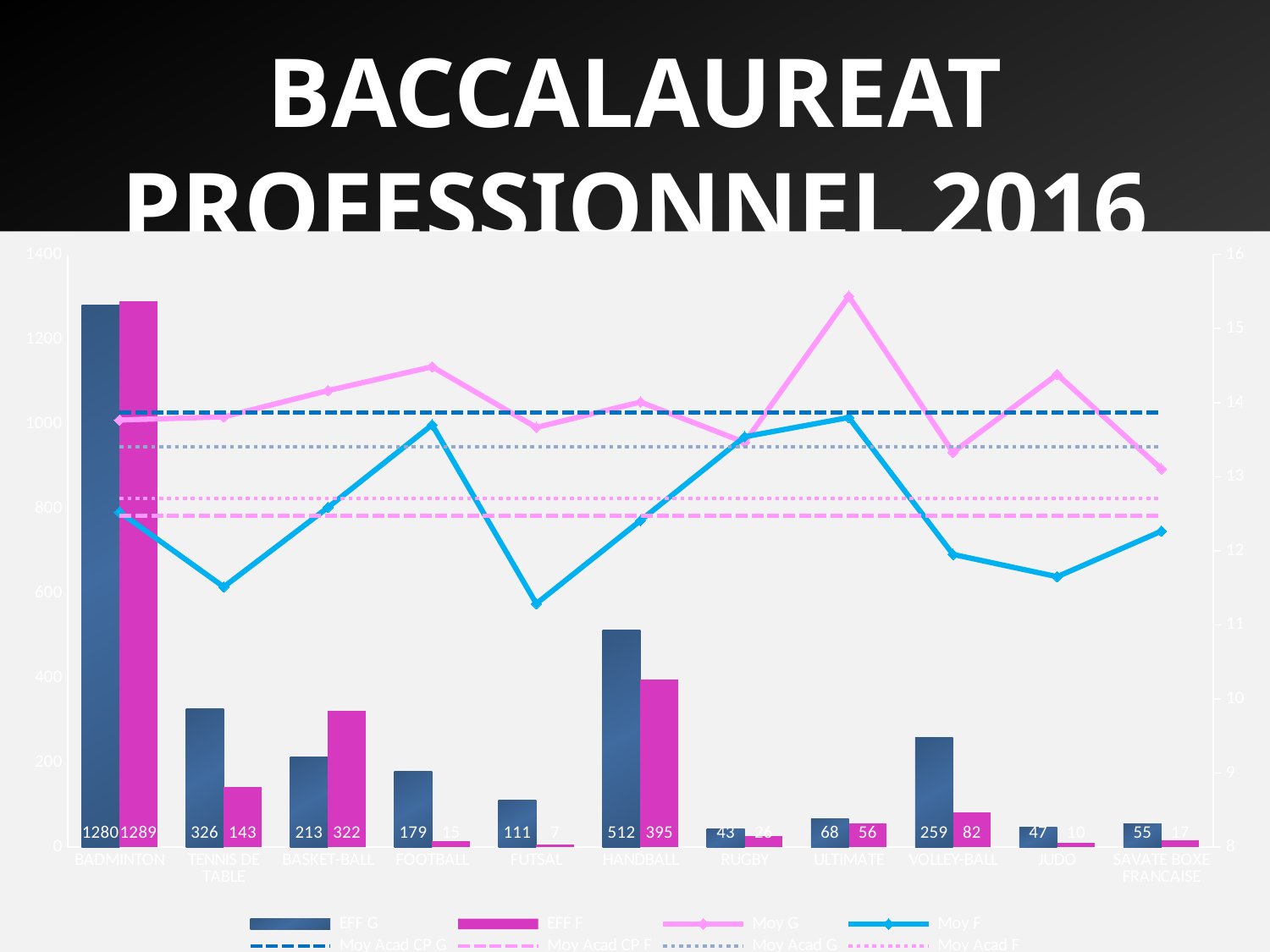
What is the EFF F value for BASKET-BALL? 322 What is the total of the EFF G and EFF F values for JUDO? 57 Which category has the highest EFF G value? BADMINTON What is the difference between the EFF G and EFF F values for TENNIS DE TABLE? 183 Which is larger for BASKET-BALL, the EFF G value or the EFF F value? EFF F Which category has the lowest EFF F value? FUTSAL Is the EFF G value for FOOTBALL greater or less than 200? less How many series does the legend list? 8 What is the EFF G value for HANDBALL? 512 What is the title of the slide containing the chart? BACCALAUREAT PROFESSIONNEL 2016 What is the EFF F value for VOLLEY-BALL? 82 How many sport categories are shown on the x axis? 11